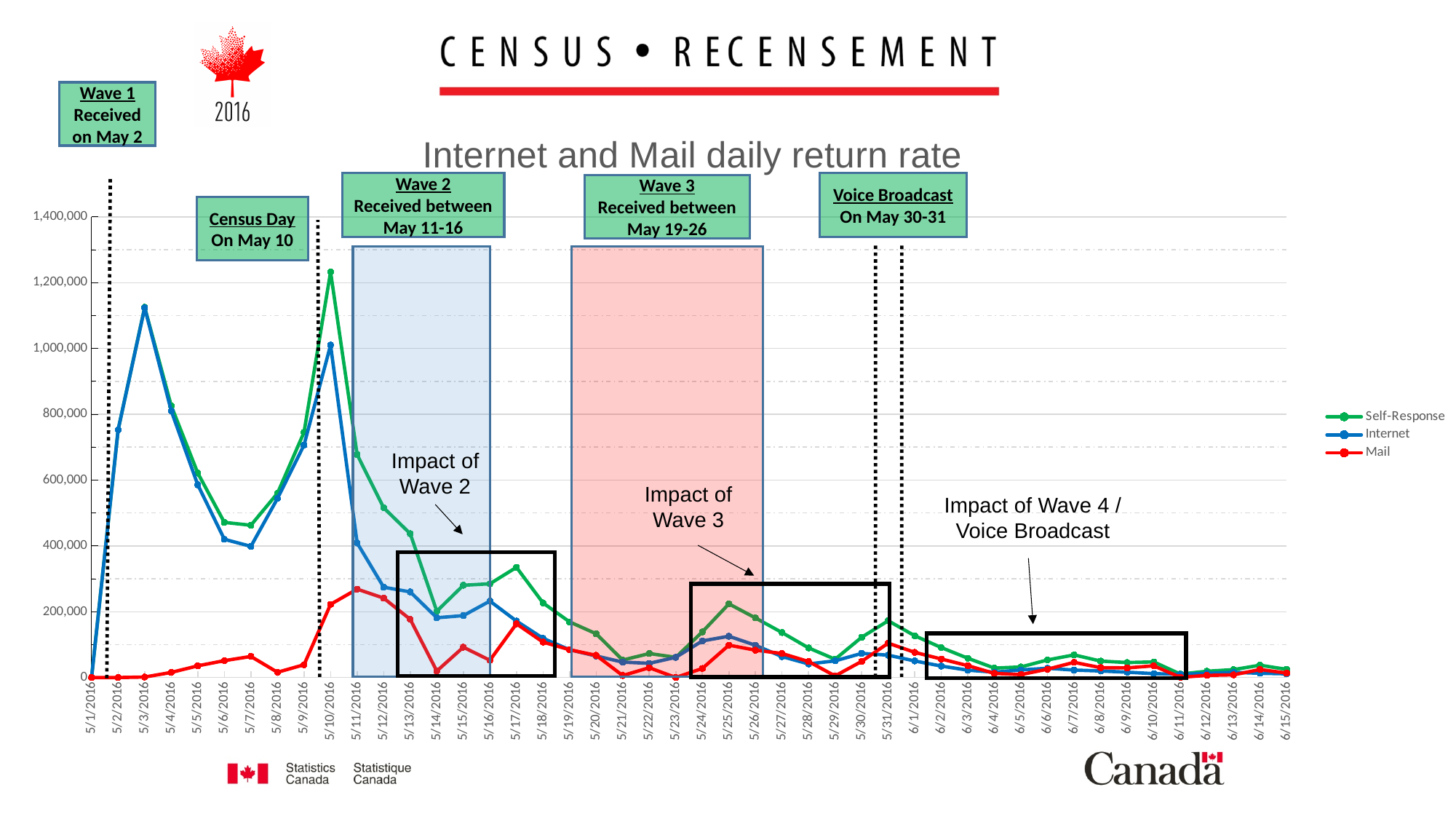
Is the Self-Response value on 5/17/2016 greater or less than 400,000? less On which date does the Self-Response series reach its highest value? 5/10/2016 Is the Mail value on 5/11/2016 greater or less than 200,000? greater What kind of chart is shown on the slide? Line chart Is the Self-Response value on 5/10/2016 greater or less than 1,000,000? greater How many series does the legend list? 3 Which colour is used for the Mail series in the legend? Red Does the Self-Response series rise or fall between 5/10/2016 and 5/14/2016? Fall On which date does the Mail series reach its highest value? 5/11/2016 On which date does the Internet series reach its highest value? 5/3/2016 What is the title of the chart? Internet and Mail daily return rate On 5/3/2016, which is larger: the Internet value or the Mail value? Internet